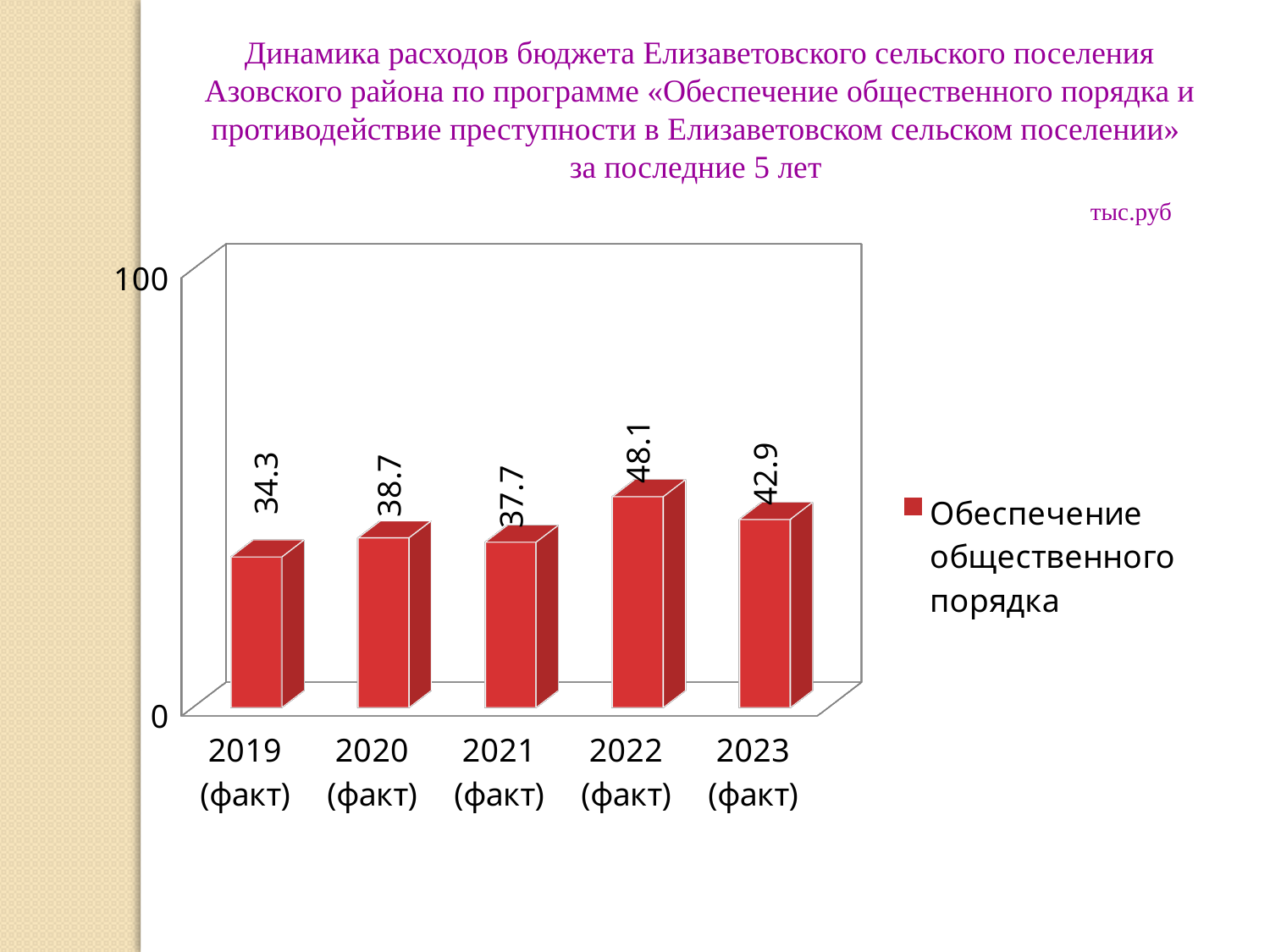
What is the value for 2019 (факт)? 34.3 How many years are shown on the x axis? 5 Is the value for 2022 (факт) greater or less than 100? less What is the difference between the values for 2020 (факт) and 2021 (факт)? 1 What is the value for 2023 (факт)? 42.9 Which year has the lowest value? 2019 (факт) What is the difference between the values for 2022 (факт) and 2019 (факт)? 13.8 Which year has the highest value? 2022 (факт) Which is larger, the value for 2023 (факт) or the value for 2020 (факт)? 2023 (факт) What kind of chart is shown on the slide? bar chart What series name does the legend show? Обеспечение общественного порядка What is the value for 2022 (факт)? 48.1